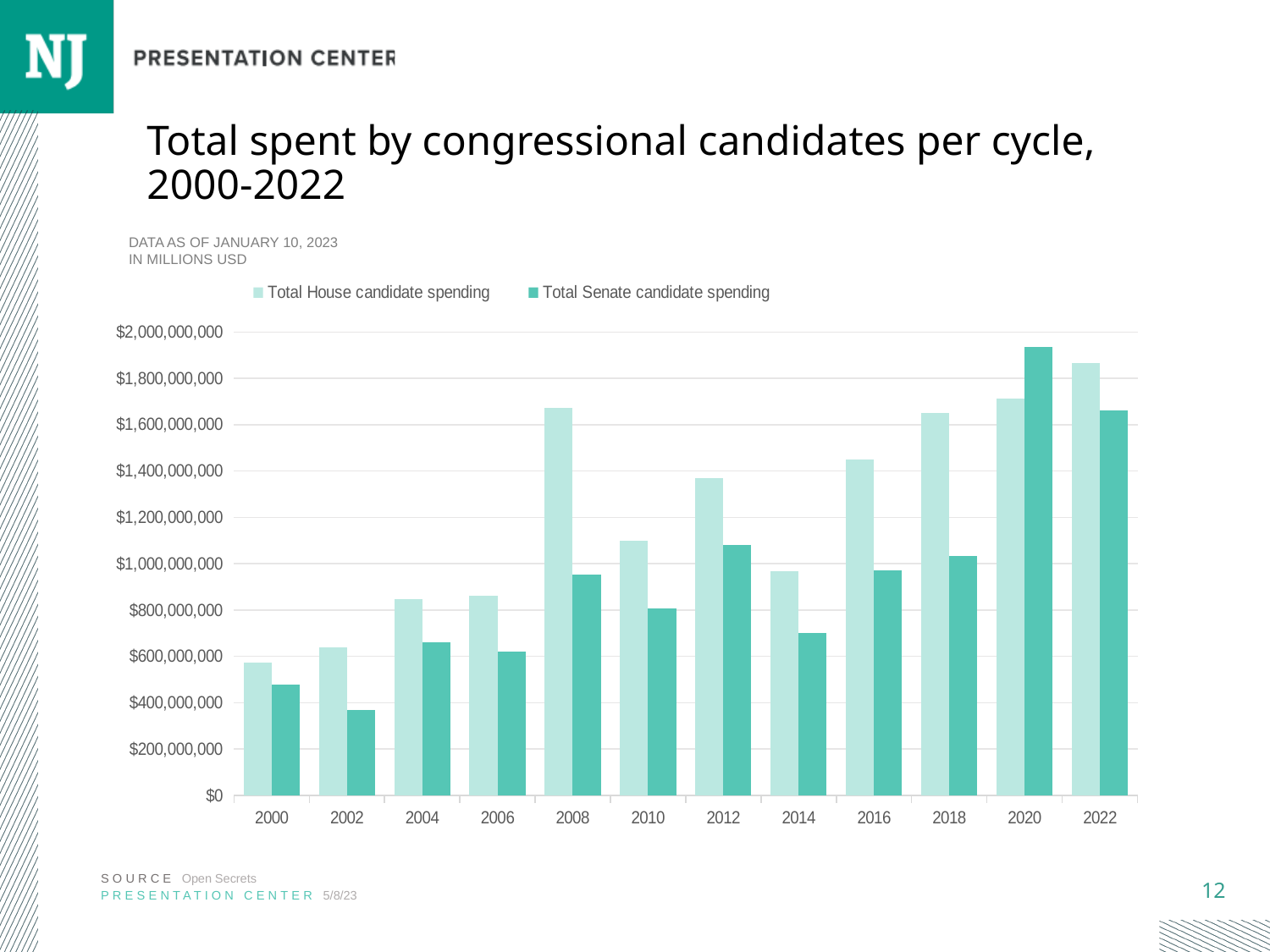
In which cycle is Total House candidate spending highest? 2022 In 2020, which is larger: Total House candidate spending or Total Senate candidate spending? Total Senate candidate spending What kind of chart is shown on the slide? Bar chart Is Total House candidate spending in 2008 greater or less than $1,600,000,000? greater In which cycle is Total House candidate spending lowest? 2000 How many election cycles are shown on the x axis? 12 Does Total House candidate spending rise or fall from 2000 to 2008? rise Is Total Senate candidate spending in 2002 greater or less than $400,000,000? less Is Total Senate candidate spending in 2020 greater or less than $1,800,000,000? greater In which cycle is Total Senate candidate spending highest? 2020 How many series does the legend list? 2 In which cycle is Total Senate candidate spending lowest? 2002